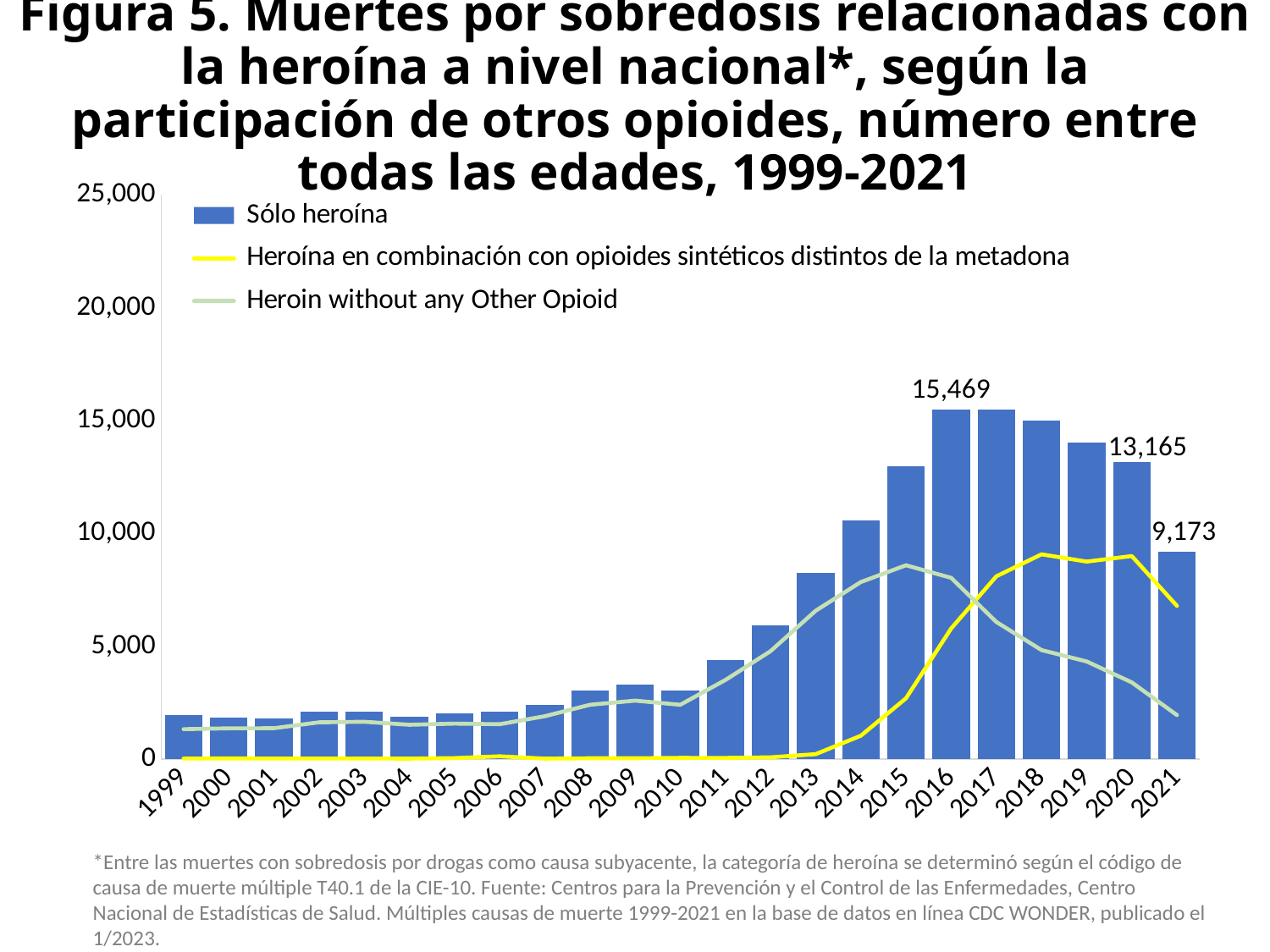
How many years are shown on the x axis? 23 What is the difference between the Sólo heroína values for 2016 and 2021? 6,296 Is the Sólo heroína value for 2013 greater or less than 10,000? less How many series does the legend list? 3 What is the value of the Sólo heroína bar for 2020? 13,165 What is the value of the Sólo heroína bar for 2016? 15,469 What is the difference between the Sólo heroína values for 2020 and 2021? 3,992 Which year has the larger Sólo heroína value, 2016 or 2021? 2016 Is the Sólo heroína value for 2015 greater or less than 10,000? greater Do the Sólo heroína bars rise or fall from 2016 to 2021? fall Which colour is used for the Sólo heroína series in the legend? blue What is the value of the Sólo heroína bar for 2021? 9,173